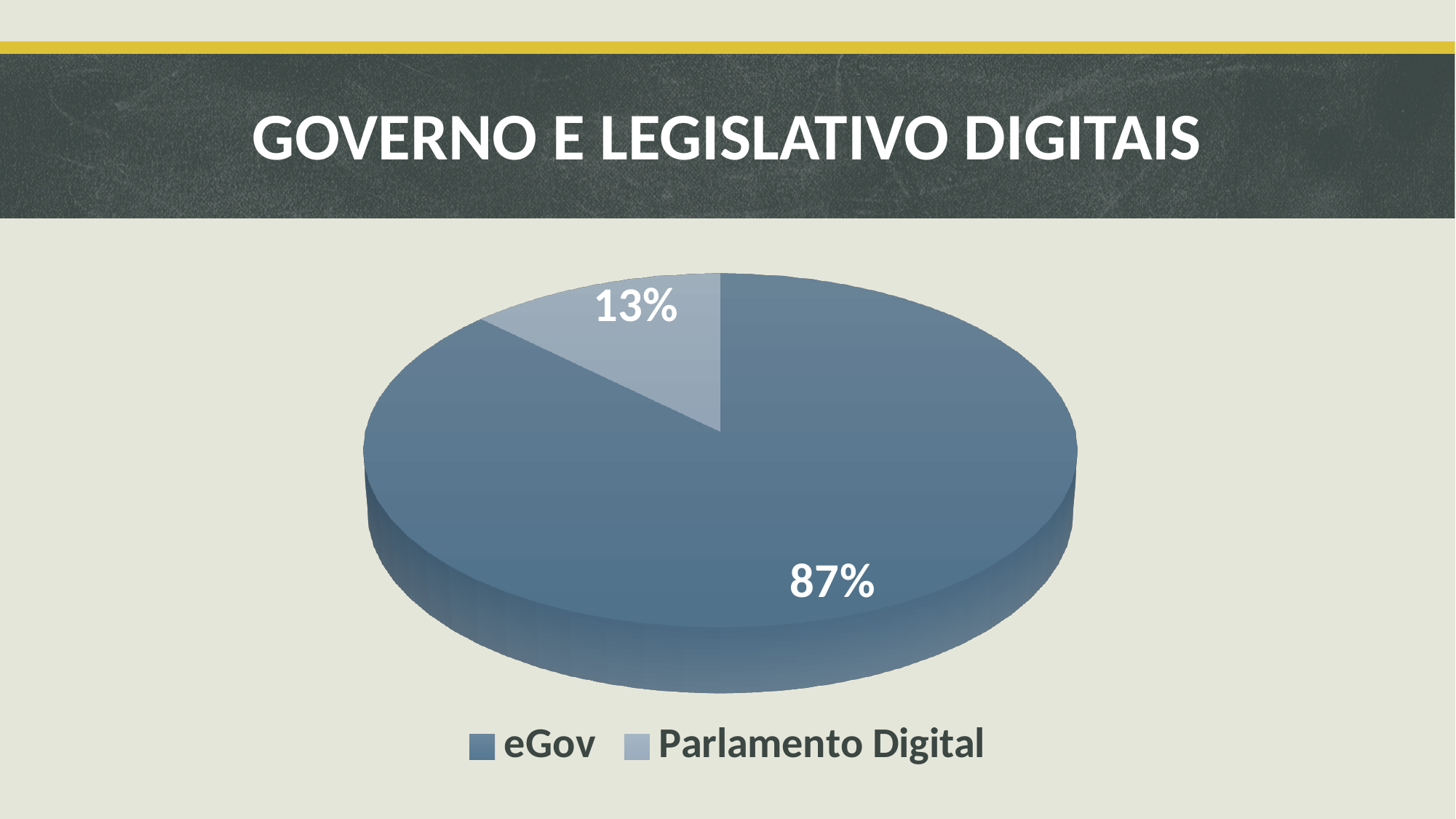
What is the title shown above the chart? GOVERNO E LEGISLATIVO DIGITAIS Which slice of the pie is the smallest? Parlamento Digital Which legend entry is shown in the lighter blue colour? Parlamento Digital How many slices does the pie chart have? 2 Which is larger, the eGov slice or the Parlamento Digital slice? eGov What share of the pie does eGov represent? 87% What is the difference in percentage points between the eGov and Parlamento Digital slices? 74 How many entries does the legend list? 2 What kind of chart is shown on the slide? pie chart Which slice of the pie is the largest? eGov What share of the pie does Parlamento Digital represent? 13%